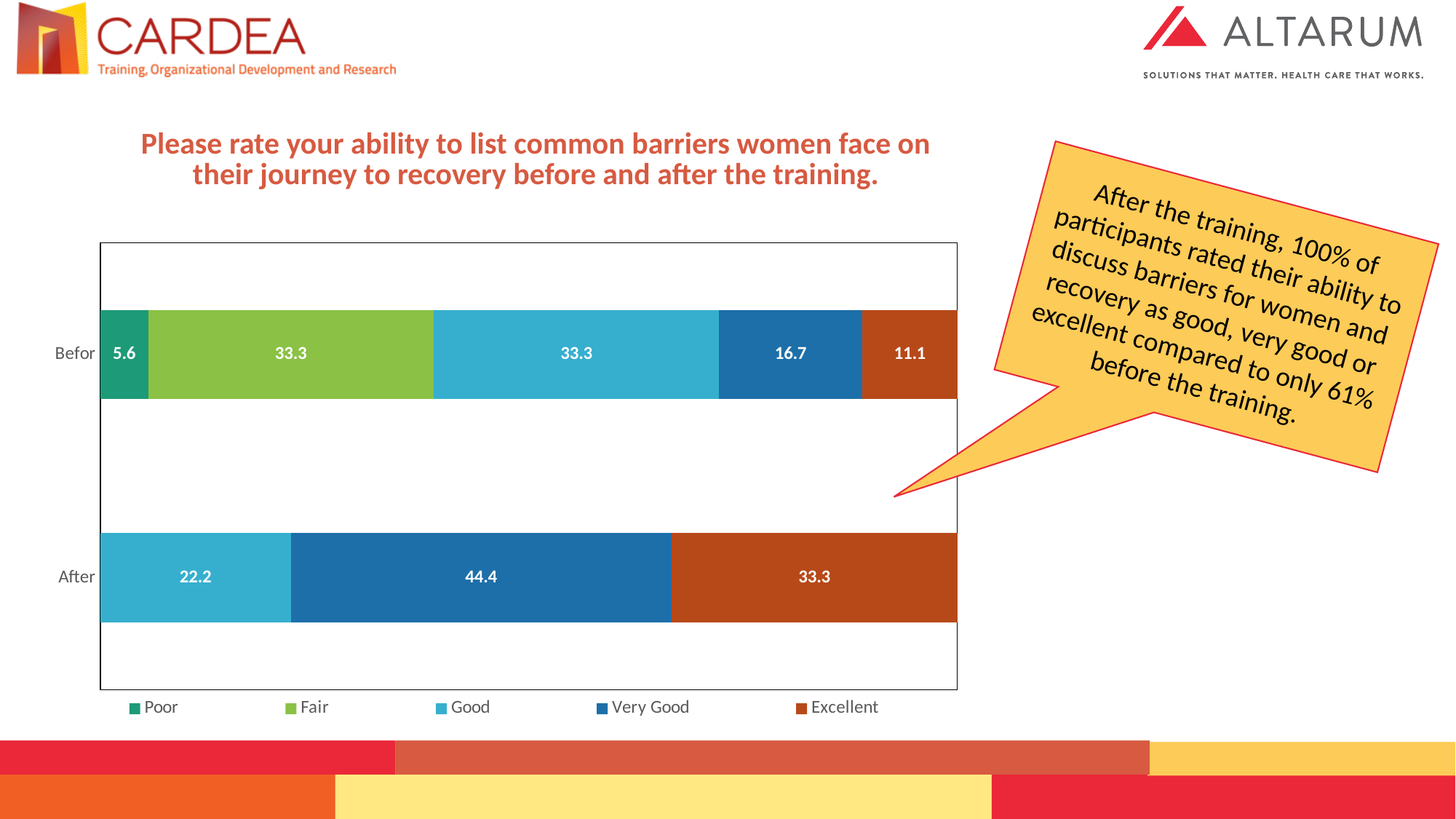
What is the difference between the Excellent values for After and Before? 22.2 Which series has the smallest value in the Before bar? Poor Which series has the largest value in the After bar? Very Good What is the value for Poor in the Before bar? 5.6 How many categories (bars) are plotted in the chart? 2 What is the value for Fair in the Before bar? 33.3 What is the value for Very Good in the After bar? 44.4 Which is larger: the Very Good value for Before or for After? After What kind of chart is shown on the slide? Stacked bar chart What is the value for Excellent in the After bar? 33.3 How many series does the legend list? 5